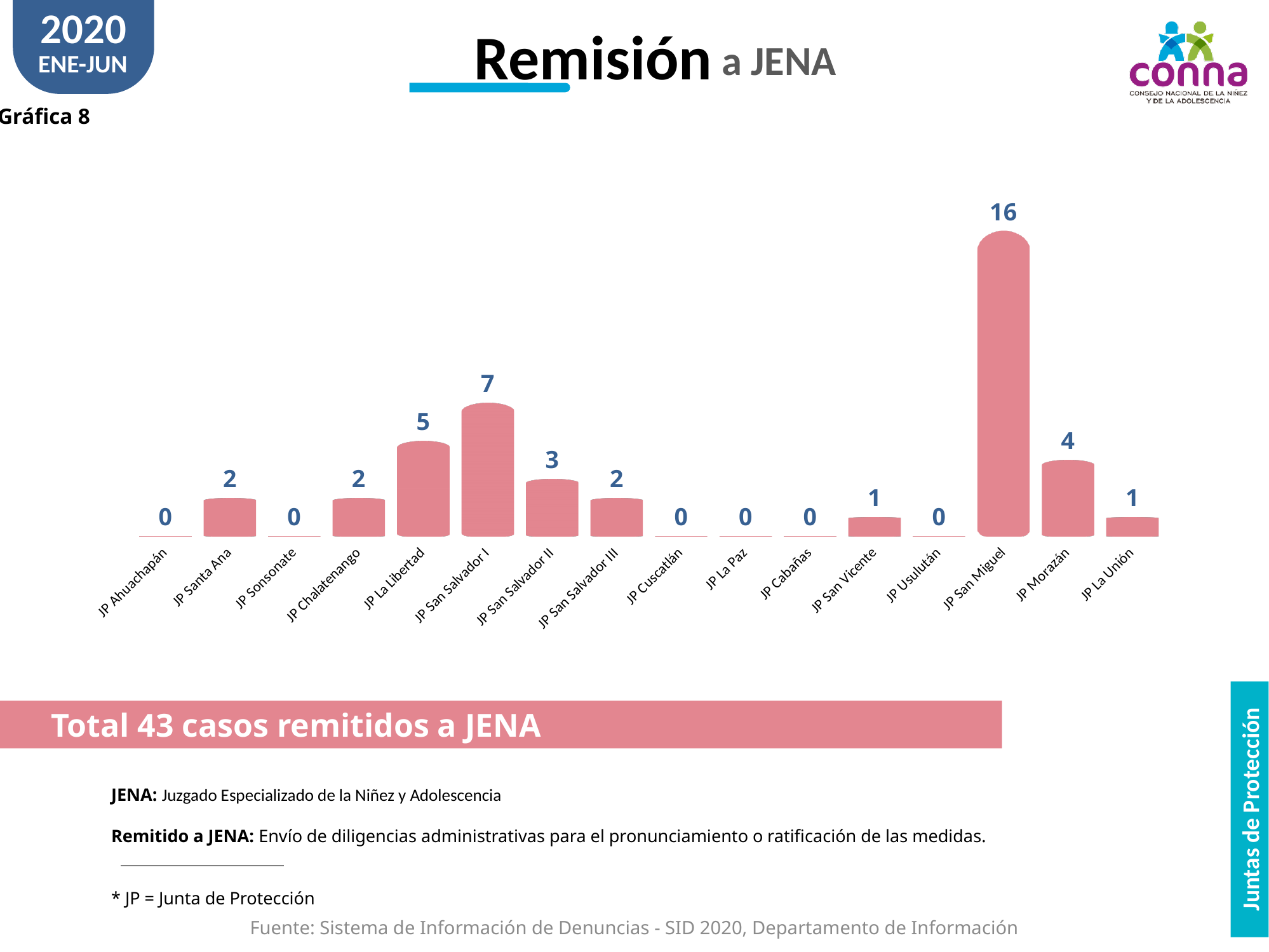
Which category has the highest value? JP San Miguel What is the difference between the values for JP Morazán and JP La Unión? 3 What is the value for JP San Miguel? 16 What total number of cases remitted to JENA is stated on the slide? 43 What is the title of the chart? Remisión a JENA What is the value for JP La Libertad? 5 What is the difference between the values for JP San Miguel and JP San Salvador I? 9 How many categories are shown on the x axis? 16 What kind of chart is shown on the slide? bar chart What is the value for JP San Salvador II? 3 How many categories have a value of 0? 6 Which is larger, the value for JP La Libertad or the value for JP Morazán? JP La Libertad